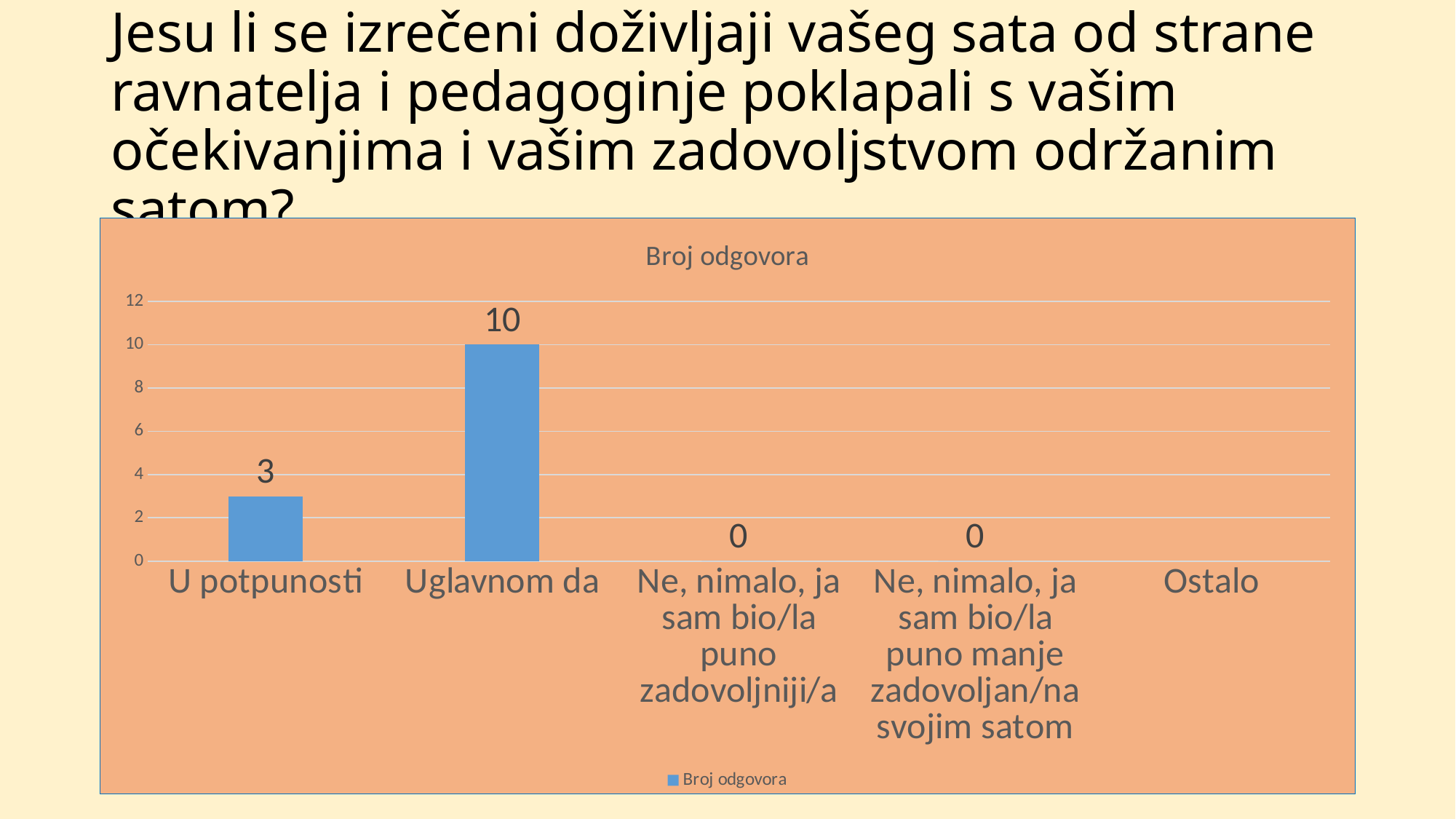
What is the value for "Ne, nimalo, ja sam bio/la puno zadovoljniji/a"? 0 What is the difference between the values for "Uglavnom da" and "U potpunosti"? 7 How many series does the legend list? 1 Which is larger, the value for "U potpunosti" or the value for "Uglavnom da"? Uglavnom da What is the title of the chart? Broj odgovora How many categories are shown on the x axis? 5 What is the value for "Ne, nimalo, ja sam bio/la puno manje zadovoljan/na svojim satom"? 0 What kind of chart is shown on the slide? bar chart What is the value for "Uglavnom da"? 10 Is the value for "Uglavnom da" greater or less than 8? greater Which category has the highest value? Uglavnom da What is the value for "U potpunosti"? 3